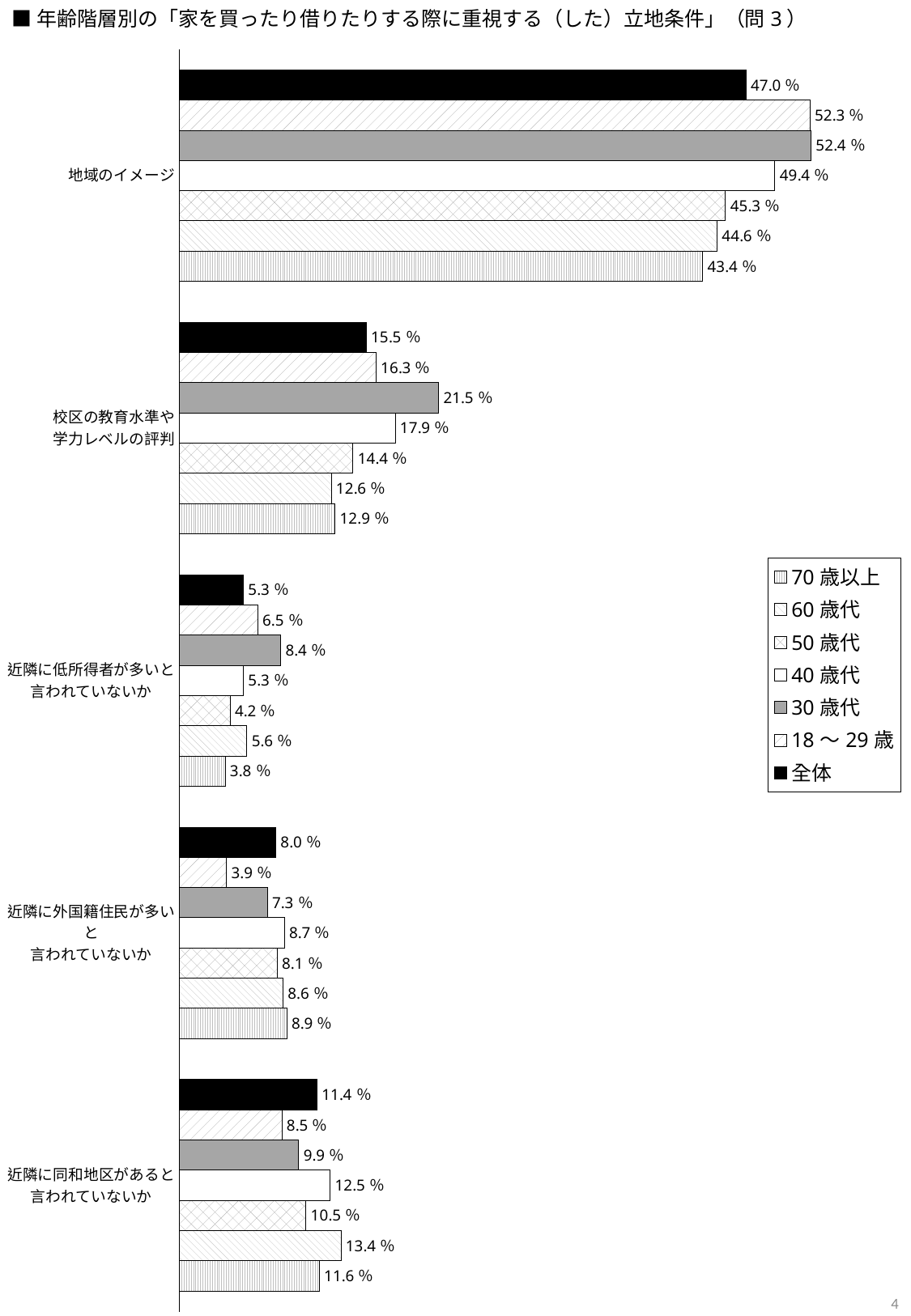
How many series does the legend list? 7 Which category has the lowest value for 全体 (black bar)? 近隣に低所得者が多いと言われていないか How many location-condition categories are shown on the chart? 5 In the 近隣に外国籍住民が多いと言われていないか category, which is larger: the 全体 value or the 30歳代 value? 全体 Which category has the highest value for 全体 (black bar)? 地域のイメージ What is the value for 全体 (black bar) in the 地域のイメージ category? 47.0 % What is the difference between the 30歳代 value and the 全体 value in the 校区の教育水準や学力レベルの評判 category? 6.0 % What is the value for 30歳代 (gray bar) in the 近隣に低所得者が多いと言われていないか category? 8.4 % What is the value for 30歳代 (gray bar) in the 校区の教育水準や学力レベルの評判 category? 21.5 % What type of chart is shown on the slide? bar chart What is the value for 全体 (black bar) in the 近隣に同和地区があると言われていないか category? 11.4 % Which series is shown with a solid black bar in the legend? 全体